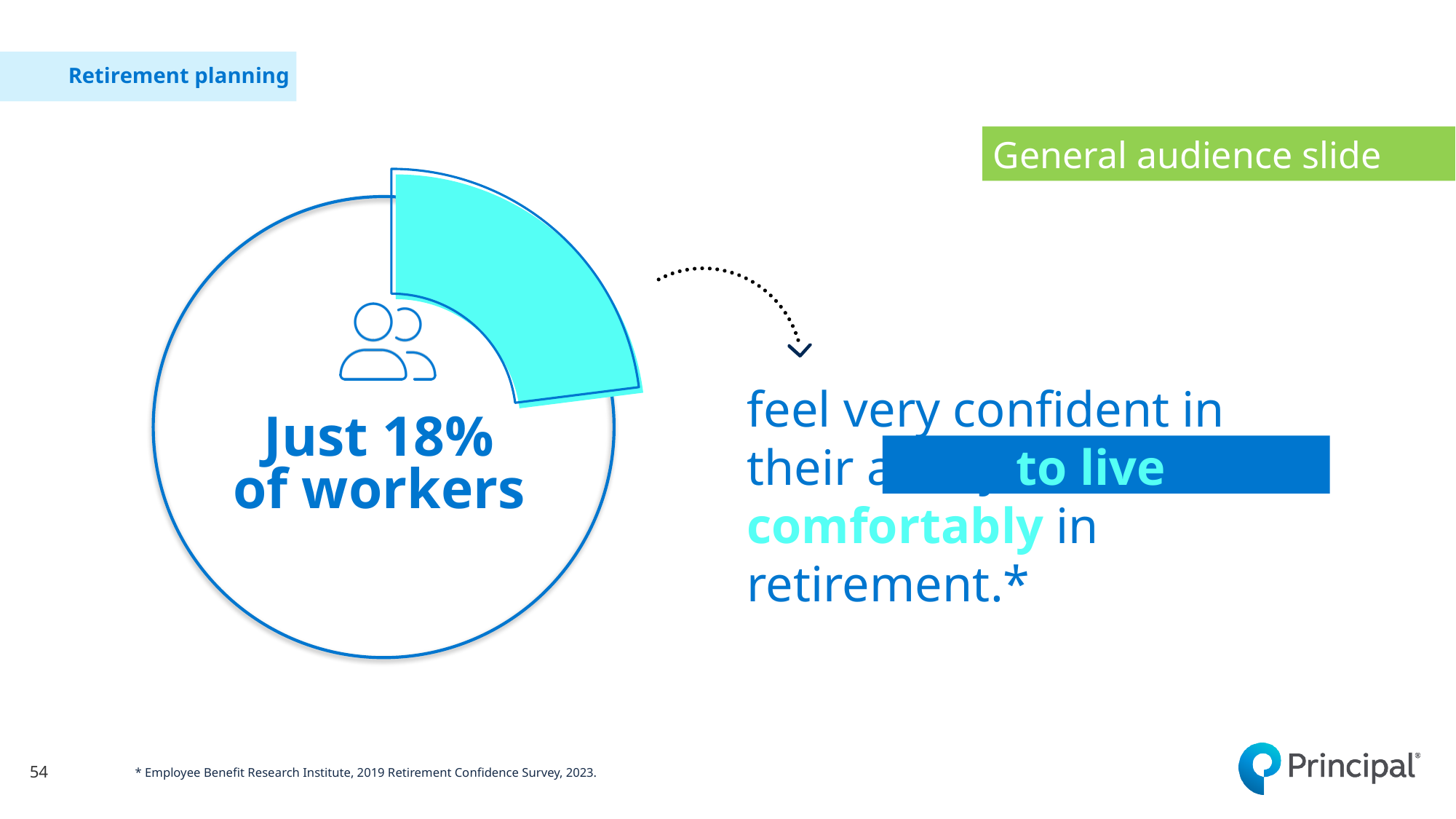
What kind of chart is shown on the slide? pie chart According to the pie chart, what percentage of workers feel very confident in their ability to live comfortably in retirement? 18% How many segments does the pie chart have? 2 What colour is the highlighted slice of the pie chart? light cyan What text is printed inside the pie chart? Just 18% of workers What share of the pie is not highlighted? 82% What share of workers does the highlighted slice of the pie chart represent? 18% Is the highlighted slice of the pie chart larger or smaller than the remaining portion? smaller